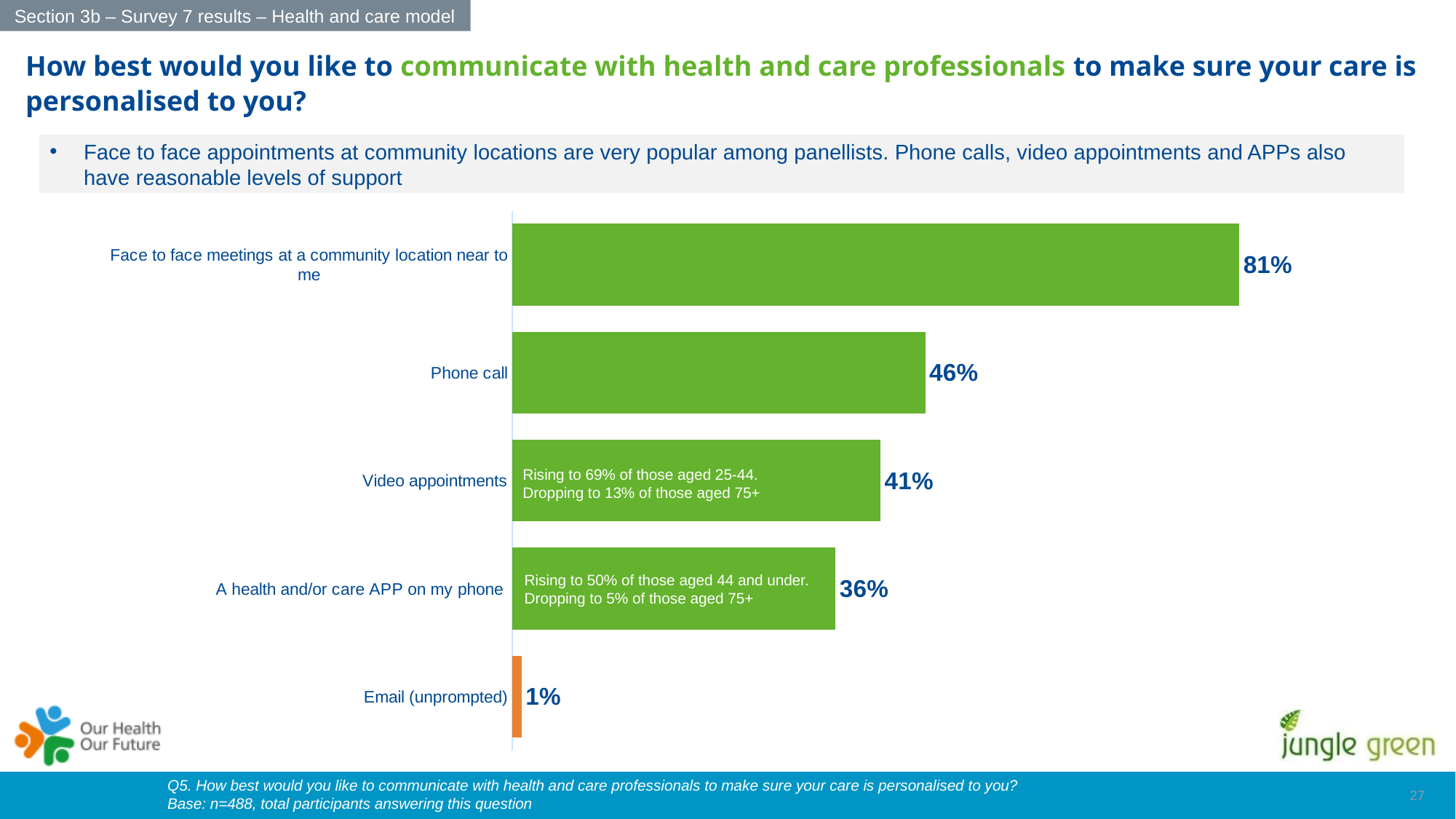
How many categories are shown in the chart? 5 What is the value for Email (unprompted)? 1% What is the difference between the values for Face to face meetings at a community location near to me and A health and/or care APP on my phone? 45% What is the difference between the values for Phone call and Video appointments? 5% What kind of chart is shown on the slide? Bar chart What percentage of panellists chose face to face meetings at a community location near to me? 81% Which communication method has the lowest value? Email (unprompted) What is the value for Phone call? 46% What is the value for Video appointments? 41% Which communication method has the highest value? Face to face meetings at a community location near to me What is the value for A health and/or care APP on my phone? 36% Which is larger, the value for Video appointments or the value for A health and/or care APP on my phone? Video appointments